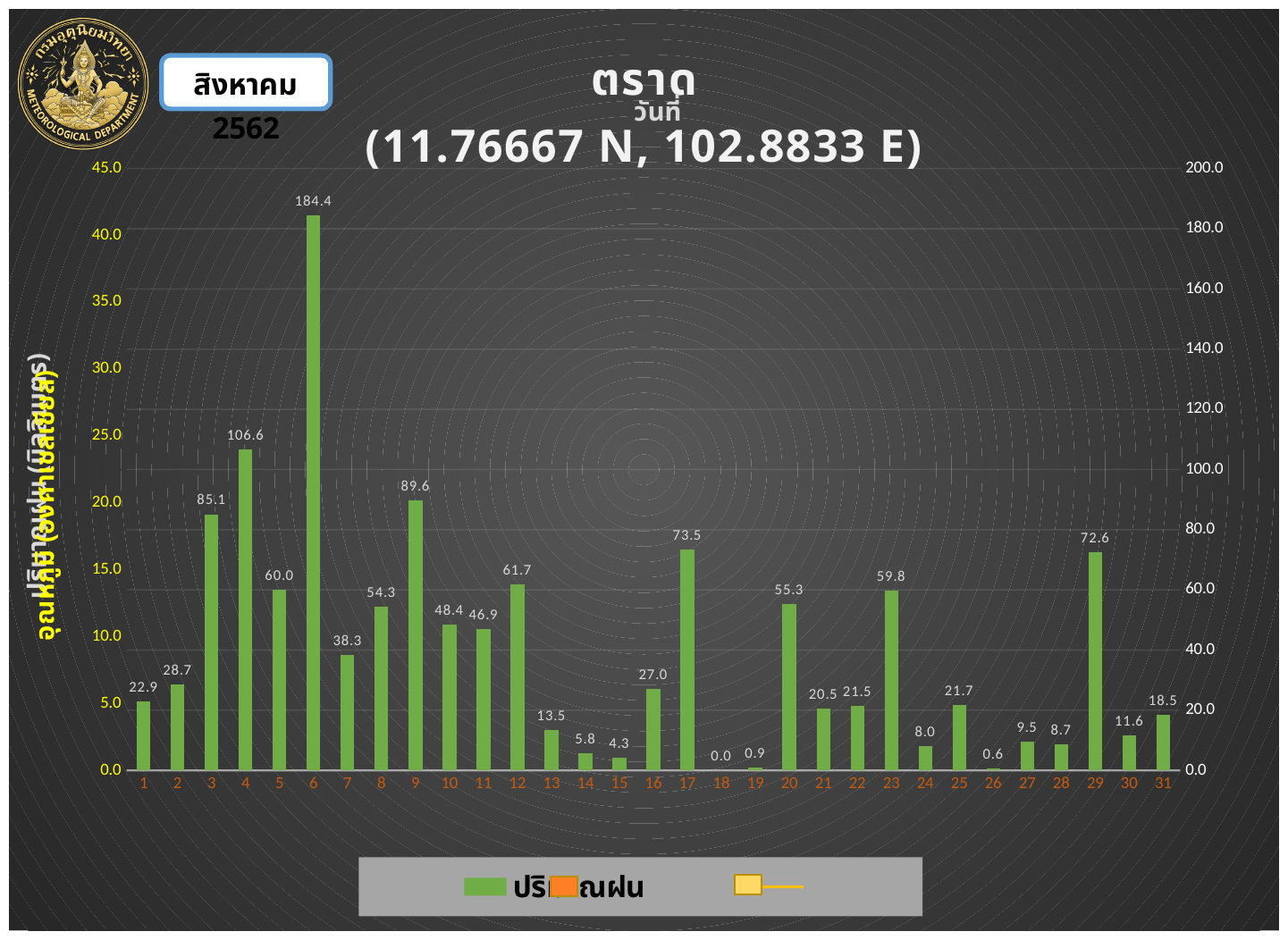
What is the value for day 29? 72.6 What is the difference between the values for day 9 and day 8? 35.3 Which is larger, the value for day 12 or the value for day 23? day 12 What is the difference between the values for day 4 and day 3? 21.5 How many days are shown on the x axis? 31 What is the value for day 17? 73.5 What kind of chart is shown on the slide? bar chart Which day has the highest value? 6 Do the values rise or fall from day 13 to day 15? fall What is the value for day 6? 184.4 What is the value for day 19? 0.9 Which day has the lowest value? 18